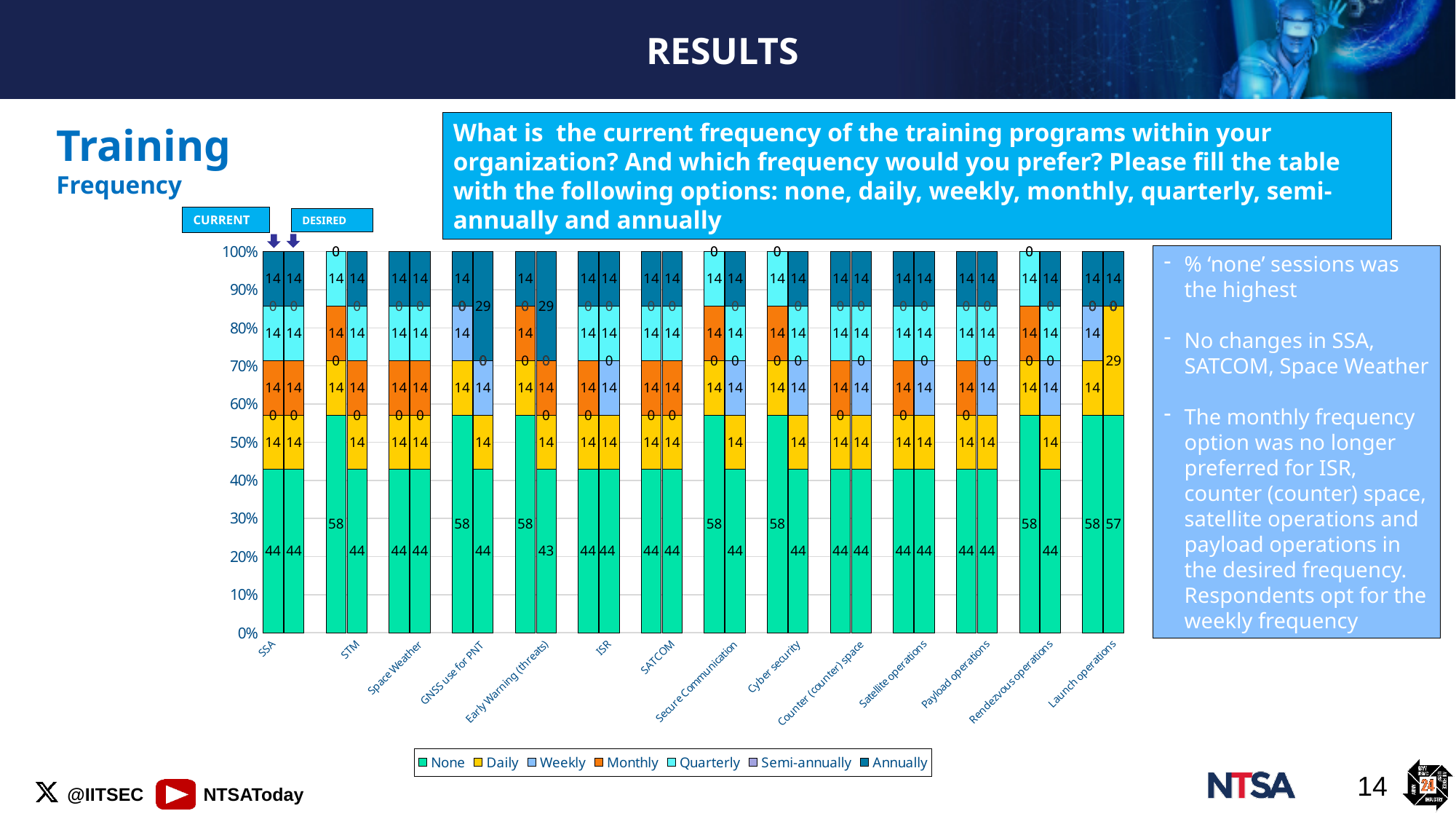
Which legend entry is shown in green? None Which is larger for STM: the 'None' value in the current bar or in the desired bar? Current What kind of chart is shown on the slide? Stacked bar chart What is the 'None' value for the desired bar of Launch operations? 57 What is the 'None' value for the desired bar of Early Warning (threats)? 43 Is the 'None' value for the current bar of Rendezvous operations greater or less than 50%? greater What is the 'Daily' value for the desired bar of Launch operations? 29 What is the 'Annually' value for the desired bar of GNSS use for PNT? 29 How many training categories are shown along the x axis? 14 What is the difference between the 'None' value in the current bar (58) and the desired bar (44) for STM? 14 What is the 'None' value for the current bar of STM? 58 How many series does the legend list? 7